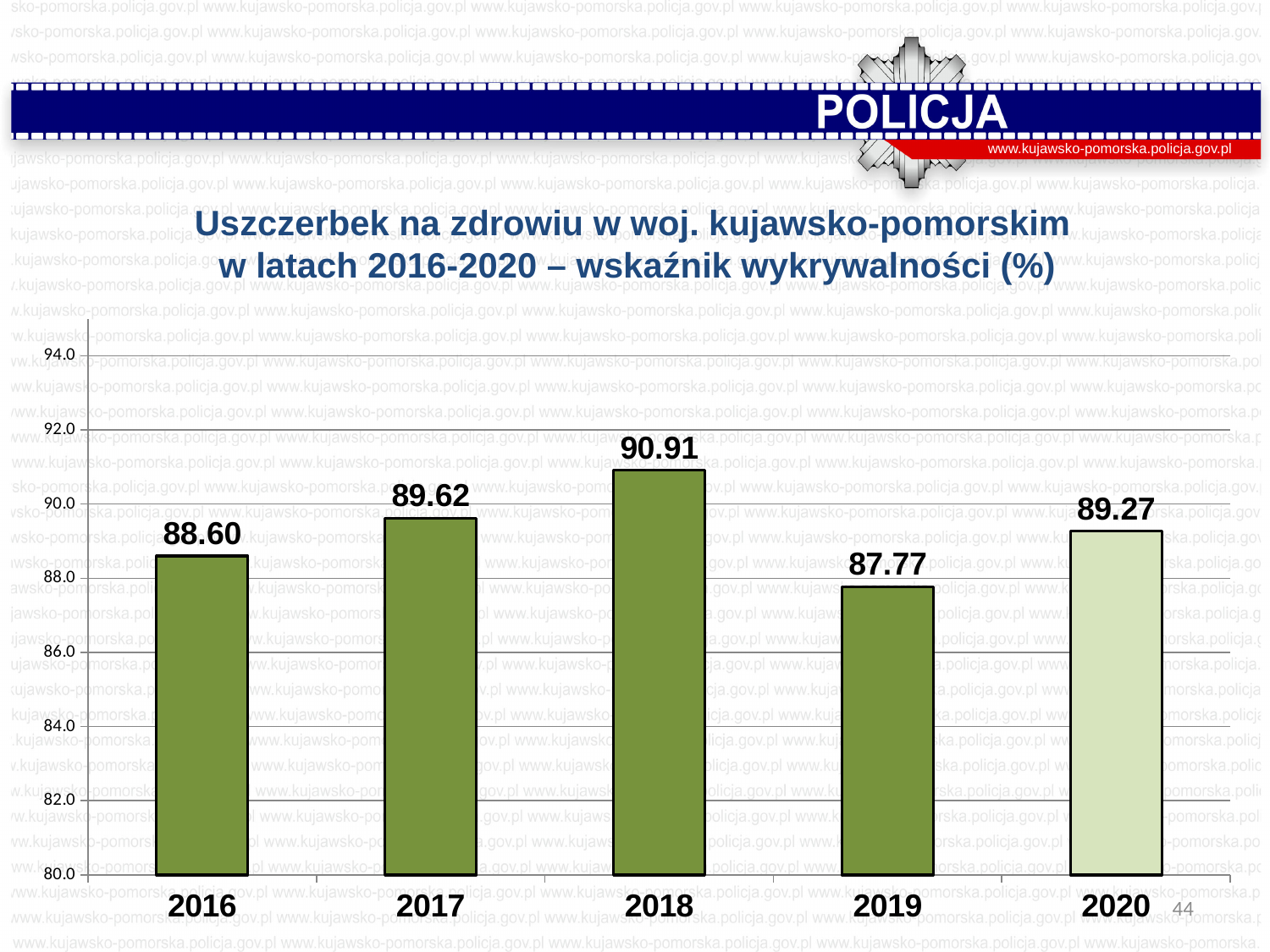
Is the value for 2019 greater or less than 88.0? less Does the value rise or fall from 2016 to 2018? rise Which bar is shown in a lighter colour than the others? 2020 Which is larger, the value for 2017 or the value for 2020? 2017 What is the value for 2016? 88.60 How many years are shown on the chart? 5 Which year has the highest value? 2018 Which year has the lowest value? 2019 What is the difference between the values for 2018 and 2019? 3.14 What kind of chart is this? bar chart What is the value for 2020? 89.27 What is the value for 2018? 90.91